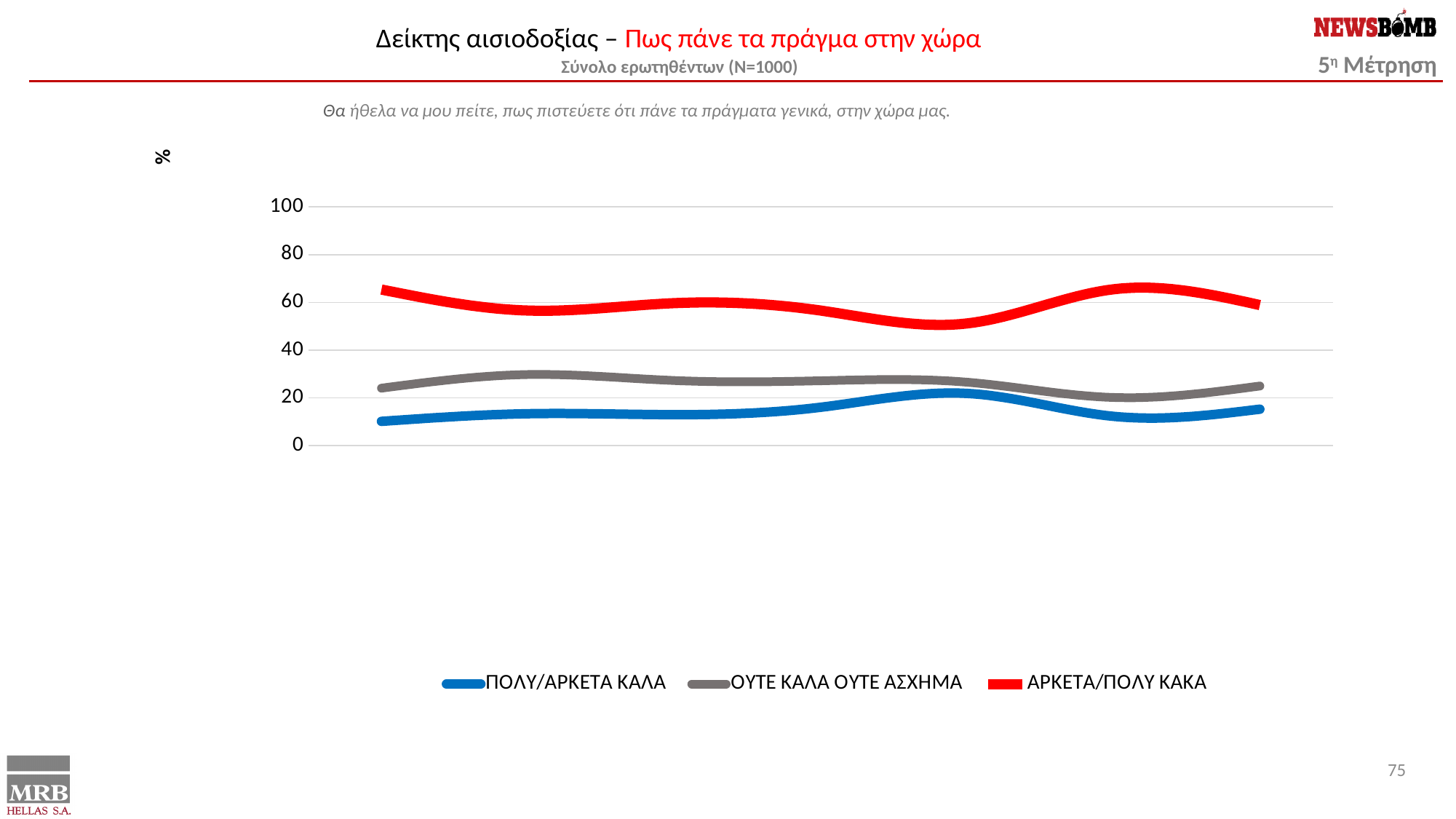
What is the highest value shown on the vertical axis? 100 Is the rightmost value of ΟΥΤΕ ΚΑΛΑ ΟΥΤΕ ΑΣΧΗΜΑ greater or less than 40? less Is the leftmost value of ΑΡΚΕΤΑ/ΠΟΛΥ ΚΑΚΑ greater or less than 60? greater Is the leftmost value of ΠΟΛΥ/ΑΡΚΕΤΑ ΚΑΛΑ greater or less than 20? less At the leftmost point, which series is larger: ΟΥΤΕ ΚΑΛΑ ΟΥΤΕ ΑΣΧΗΜΑ or ΠΟΛΥ/ΑΡΚΕΤΑ ΚΑΛΑ? ΟΥΤΕ ΚΑΛΑ ΟΥΤΕ ΑΣΧΗΜΑ Which series has the highest values across the whole chart? ΑΡΚΕΤΑ/ΠΟΛΥ ΚΑΚΑ How many series does the legend list? 3 Is the rightmost value of ΠΟΛΥ/ΑΡΚΕΤΑ ΚΑΛΑ higher or lower than its leftmost value? higher Which series has the lowest values across the whole chart? ΠΟΛΥ/ΑΡΚΕΤΑ ΚΑΛΑ Which series is plotted with the red line? ΑΡΚΕΤΑ/ΠΟΛΥ ΚΑΚΑ What kind of chart is shown on the slide? line chart